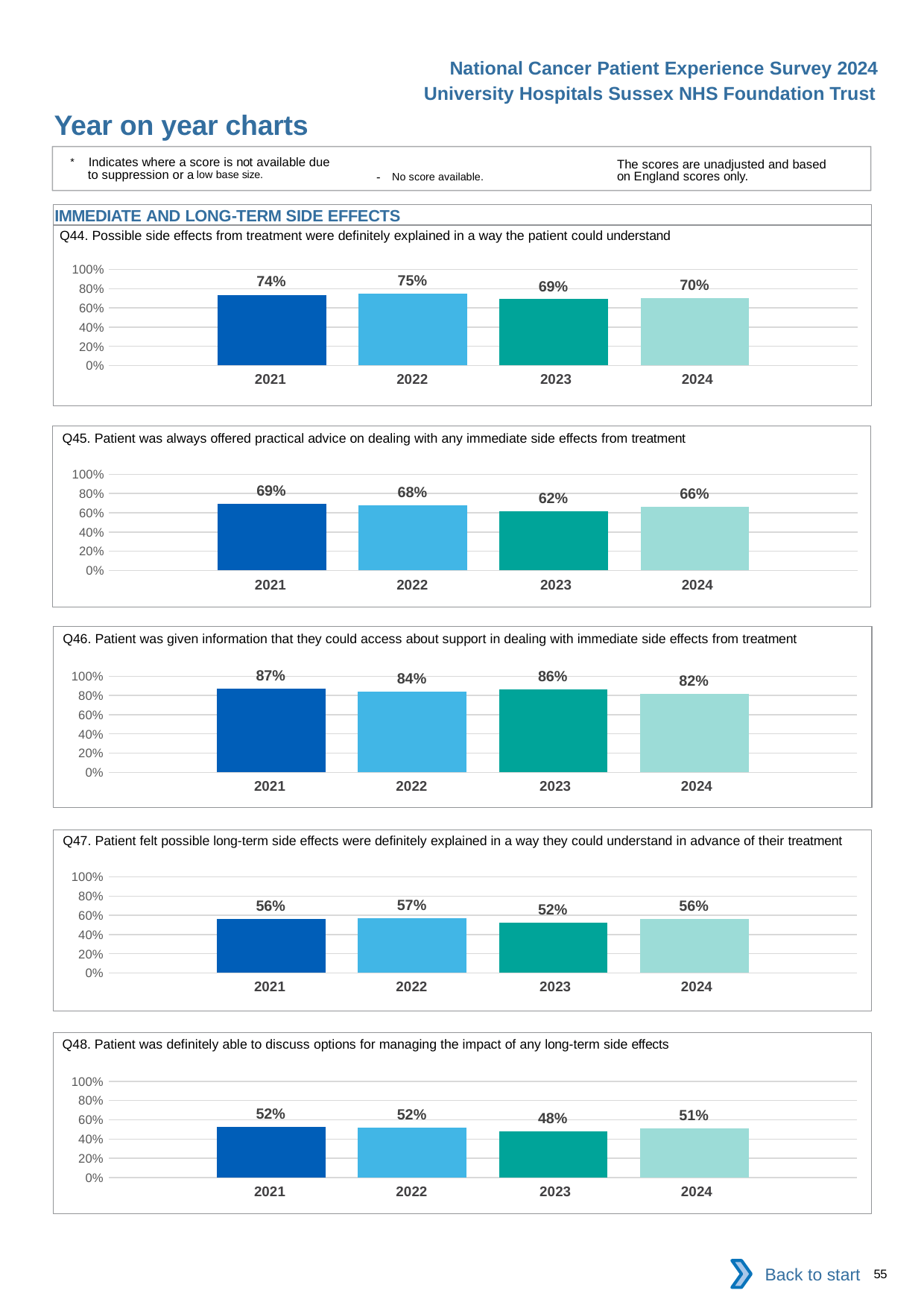
How many charts are shown on the slide? 5 In the Q44 chart, what is the value for 2022? 75% In the Q46 chart, which year has the highest value? 2021 What kind of chart is the Q45 chart? bar chart In the Q45 chart, which year has the lowest value? 2023 In the Q45 chart, what is the difference between the 2021 value and the 2024 value? 3% How many years are shown in the Q44 chart? 4 In the Q47 chart, what is the difference between the 2022 value and the 2023 value? 5% In the Q47 chart, is the value for 2023 greater or less than 60%? less In the Q46 chart, is the value for 2024 greater or less than 60%? greater In the Q48 chart, which is larger, the value for 2021 or the value for 2023? 2021 In the Q48 chart, what is the value for 2024? 51%